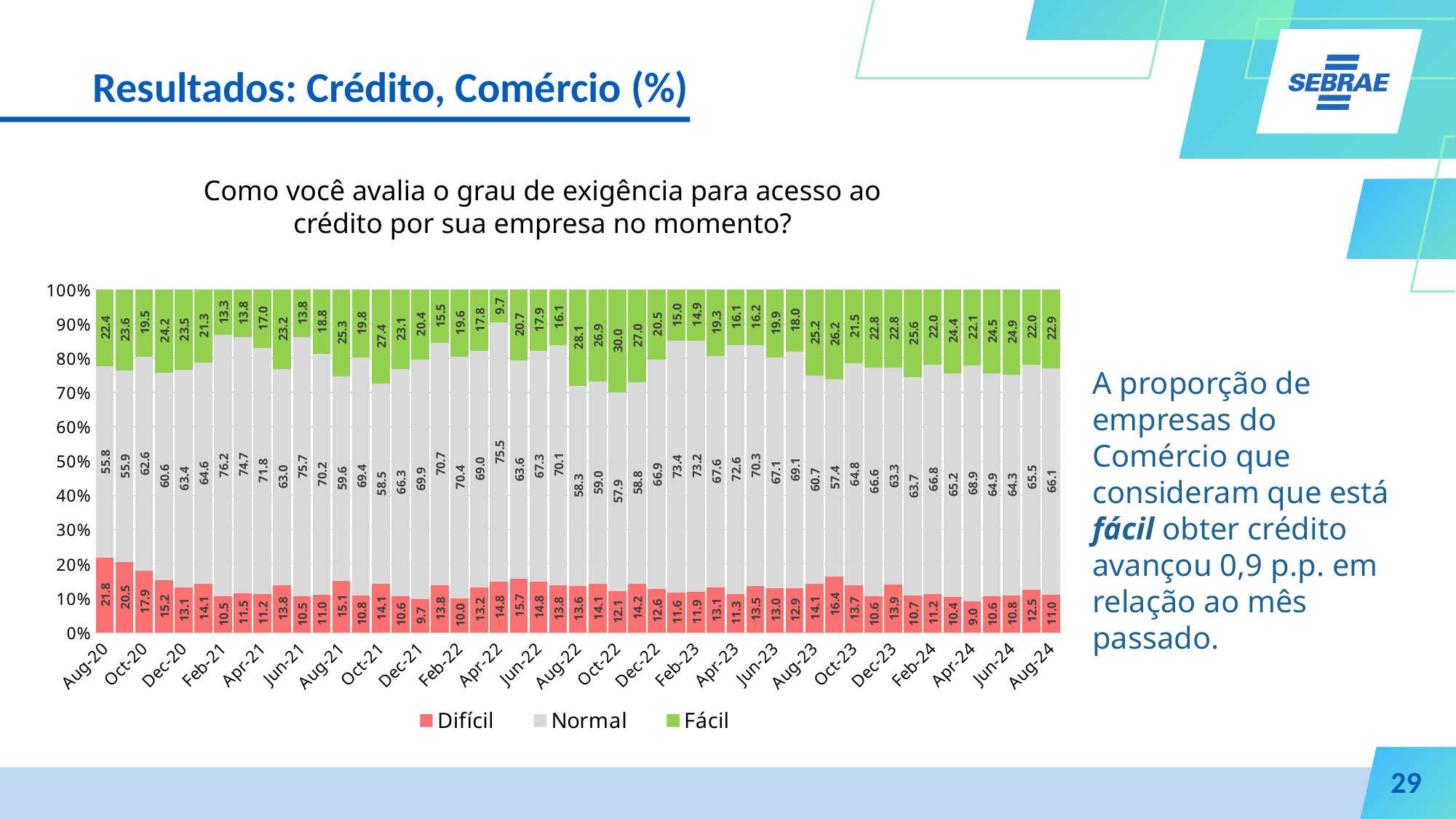
What type of chart is shown on the slide? stacked bar chart What is the difference between the Normal value in Feb-21 and the Normal value in Aug-20? 20.4 In which month is the Fácil value highest? Oct-22 What is the Normal value for Oct-22? 57.9 In which month is the Fácil value lowest? Apr-22 What is the Difícil value for Aug-20? 21.8 What is the difference between the Fácil value in Oct-22 and the Fácil value in Apr-22? 20.3 How many series does the legend list? 3 Which is larger, the Difícil value for Aug-20 or the Difícil value for Aug-24? Aug-20 In which month is the Difícil value lowest? Apr-24 What is the Fácil value for Aug-24? 22.9 Which series is shown in green in the legend? Fácil